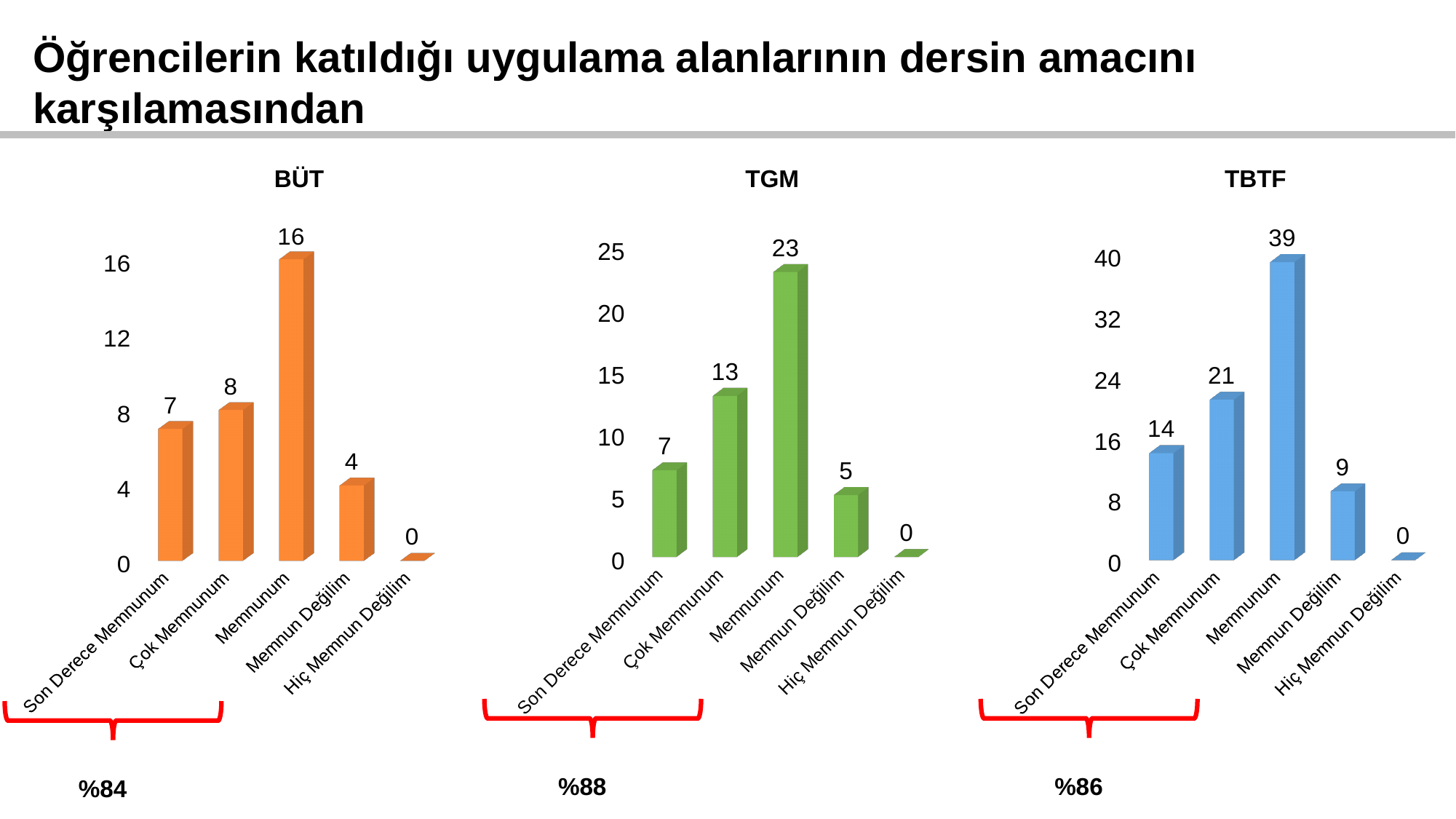
In the TBTF chart, which category has the highest value? Memnunum In the TBTF chart, is the value for Çok Memnunum greater or less than 16? greater In the TBTF chart, what is the difference between Memnunum and Memnun Değilim? 30 In the BÜT chart, what is the difference between Memnunum and Çok Memnunum? 8 In the TGM chart, what is the value for Çok Memnunum? 13 What kind of chart is the TGM chart? bar chart How many categories does the BÜT chart show? 5 In the TGM chart, which is larger, Son Derece Memnunum or Memnun Değilim? Son Derece Memnunum What colour are the bars in the TBTF chart? blue In the TGM chart, which category has the lowest value? Hiç Memnun Değilim In the BÜT chart, what is the value for Memnunum? 16 In the TBTF chart, what is the value for Son Derece Memnunum? 14